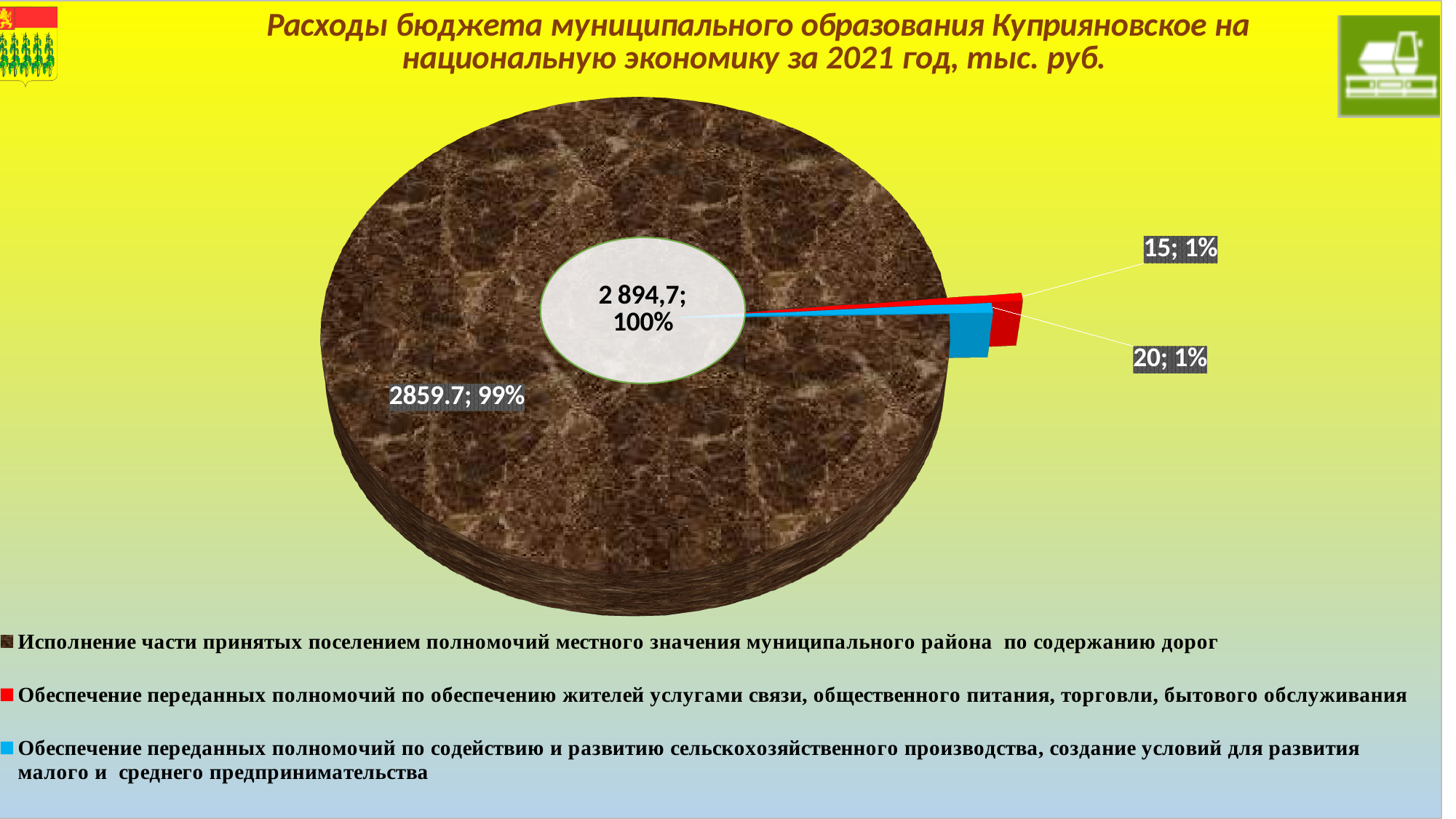
What share of the pie does the slice for road maintenance ("по содержанию дорог") represent? 99% What is the difference between the value for the blue slice (20) and the red slice (15)? 5 Which is larger: the value for the red slice (услуги связи, общественного питания, торговли, бытового обслуживания) or the blue slice (сельскохозяйственное производство, малое и среднее предпринимательство)? the blue slice (20) What kind of chart is shown on the slide? pie chart Which category has the smallest slice of the pie? Обеспечение переданных полномочий по обеспечению жителей услугами связи, общественного питания, торговли, бытового обслуживания How many slices does the pie chart have? 3 What total value is shown in the centre of the pie chart? 2 894,7 How many entries does the legend list? 3 Which category has the largest slice of the pie? Исполнение части принятых поселением полномочий местного значения муниципального района по содержанию дорог What is the value for "Обеспечение переданных полномочий по содействию и развитию сельскохозяйственного производства, создание условий для развития малого и среднего предпринимательства"? 20 What is the value for "Исполнение части принятых поселением полномочий местного значения муниципального района по содержанию дорог"? 2859.7 What is the value for "Обеспечение переданных полномочий по обеспечению жителей услугами связи, общественного питания, торговли, бытового обслуживания"? 15